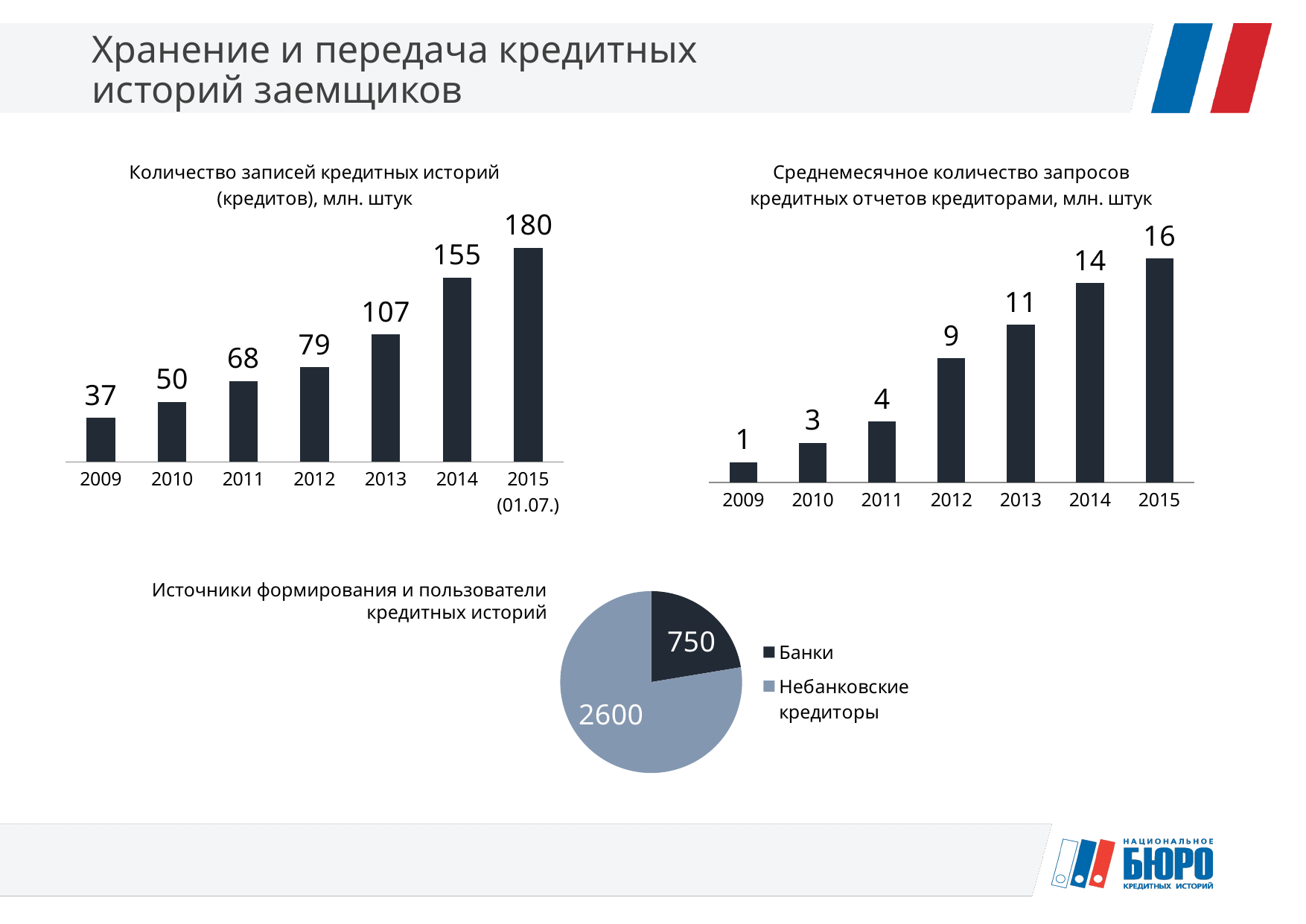
In the chart 'Количество записей кредитных историй (кредитов), млн. штук', what is the difference between the values for 2014 and 2013? 48 In the chart 'Среднемесячное количество запросов кредитных отчетов кредиторами, млн. штук', which year has the lowest value? 2009 In the pie chart 'Источники формирования и пользователи кредитных историй', which is larger: Банки or Небанковские кредиторы? Небанковские кредиторы In the pie chart 'Источники формирования и пользователи кредитных историй', what is the value for Небанковские кредиторы? 2600 In the chart 'Среднемесячное количество запросов кредитных отчетов кредиторами, млн. штук', what is the difference between the values for 2015 and 2014? 2 How many entries does the legend of the pie chart 'Источники формирования и пользователи кредитных историй' list? 2 In the chart 'Количество записей кредитных историй (кредитов), млн. штук', what is the value for 2013? 107 In the chart 'Среднемесячное количество запросов кредитных отчетов кредиторами, млн. штук', do the values rise or fall from 2009 to 2015? rise In the chart 'Количество записей кредитных историй (кредитов), млн. штук', how many years are shown on the x axis? 7 In the chart 'Количество записей кредитных историй (кредитов), млн. штук', which year has the highest value? 2015 (01.07.) What kind of chart is 'Среднемесячное количество запросов кредитных отчетов кредиторами, млн. штук'? bar chart In the chart 'Среднемесячное количество запросов кредитных отчетов кредиторами, млн. штук', what is the value for 2012? 9